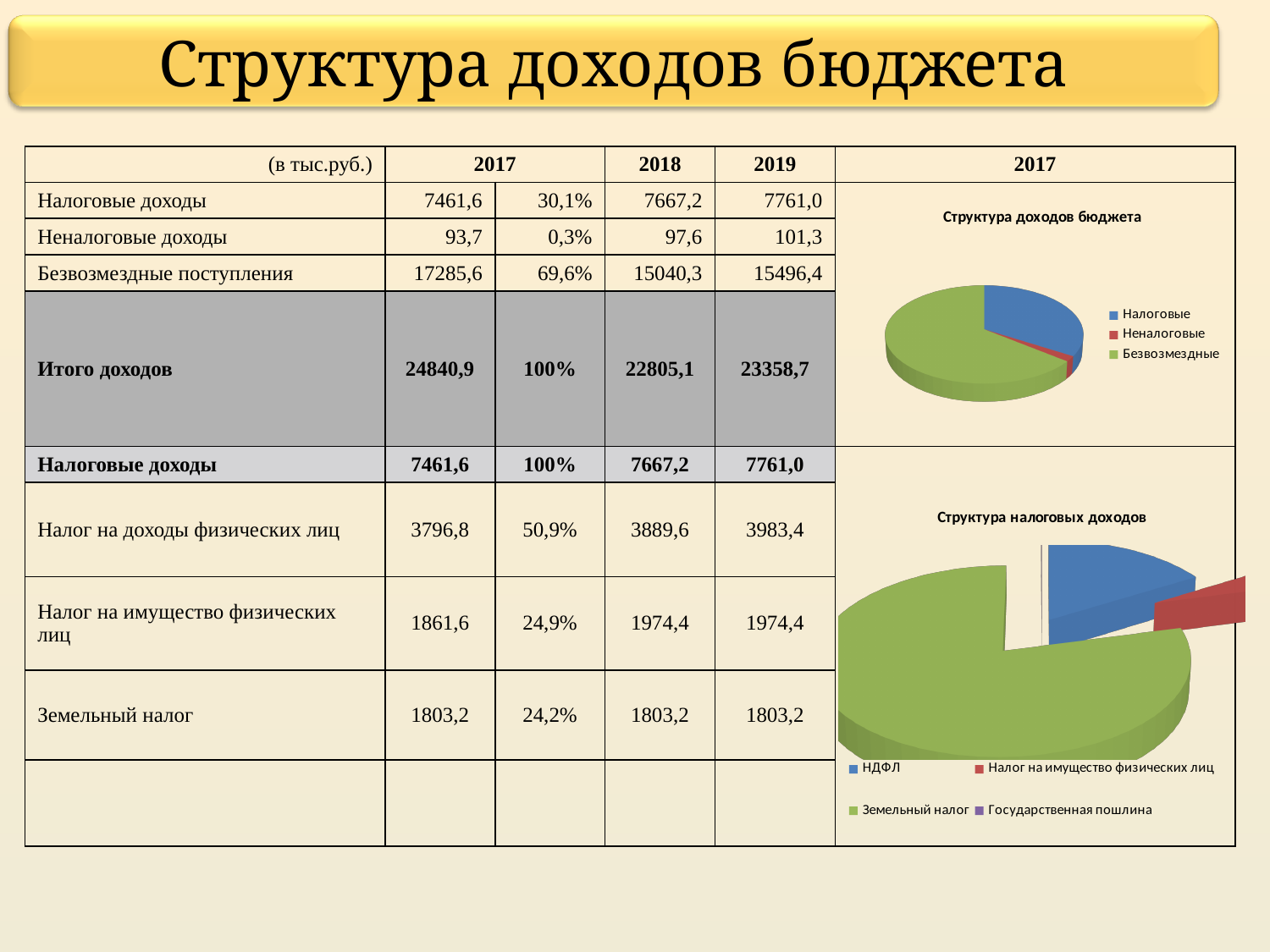
In the 'Структура доходов бюджета' chart, what colour is the Безвозмездные slice? green What kind of chart is the 'Структура доходов бюджета' chart? pie chart In the 'Структура налоговых доходов' chart, which category has the smallest slice? Государственная пошлина In the 'Структура налоговых доходов' chart, which category has the largest slice? Земельный налог In the 'Структура доходов бюджета' chart, which slice is larger: Налоговые or Неналоговые? Налоговые How many entries does the legend of the 'Структура налоговых доходов' chart list? 4 How many entries does the legend of the 'Структура доходов бюджета' chart list? 3 In the 'Структура налоговых доходов' chart, which slice is larger: НДФЛ or Налог на имущество физических лиц? НДФЛ In the 'Структура доходов бюджета' chart, which category has the smallest slice? Неналоговые In the 'Структура доходов бюджета' chart, which category has the largest slice? Безвозмездные What kind of chart is the 'Структура налоговых доходов' chart? pie chart In the 'Структура налоговых доходов' chart, what colour is the НДФЛ slice? blue